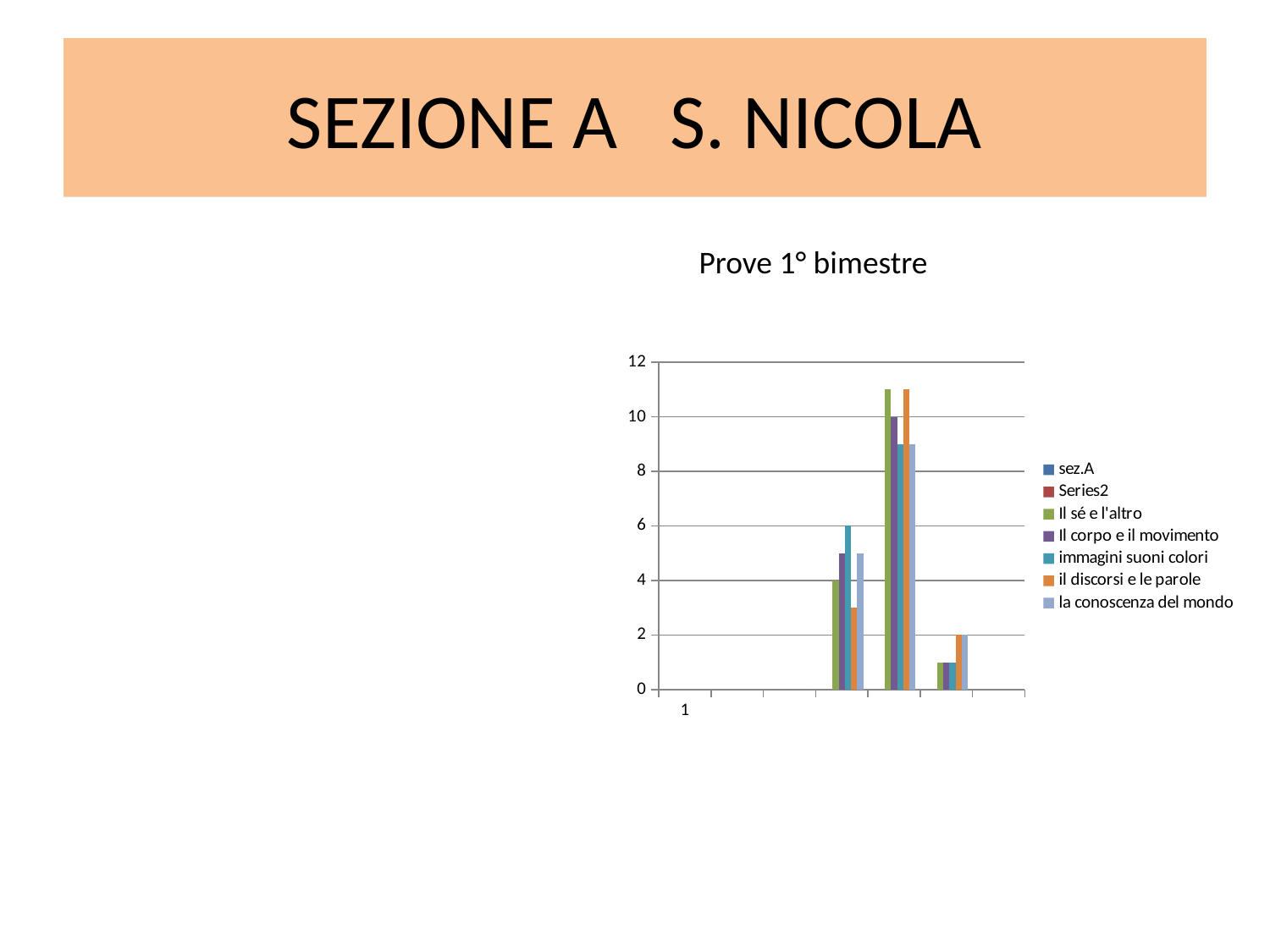
Is the tallest bar in the chart greater or less than 10? greater What kind of chart is shown on the slide? bar chart What is the title of the chart? Prove 1° bimestre How many series does the chart legend list? 7 In the third group of bars, is the value for 'il discorsi e le parole' greater or less than 4? less In the first group of bars, is the value for 'immagini suoni colori' greater or less than 4? greater How many groups of bars are plotted in the chart? 3 In the first group of bars, what value does the bar for 'Il sé e l'altro' reach? 4 What is the last entry in the chart legend? la conoscenza del mondo In the middle group of bars, what value does the bar for 'Il corpo e il movimento' reach? 10 Which group of bars, the middle one or the right-hand one, has the taller bars? the middle one What is the maximum value shown on the vertical axis of the chart? 12